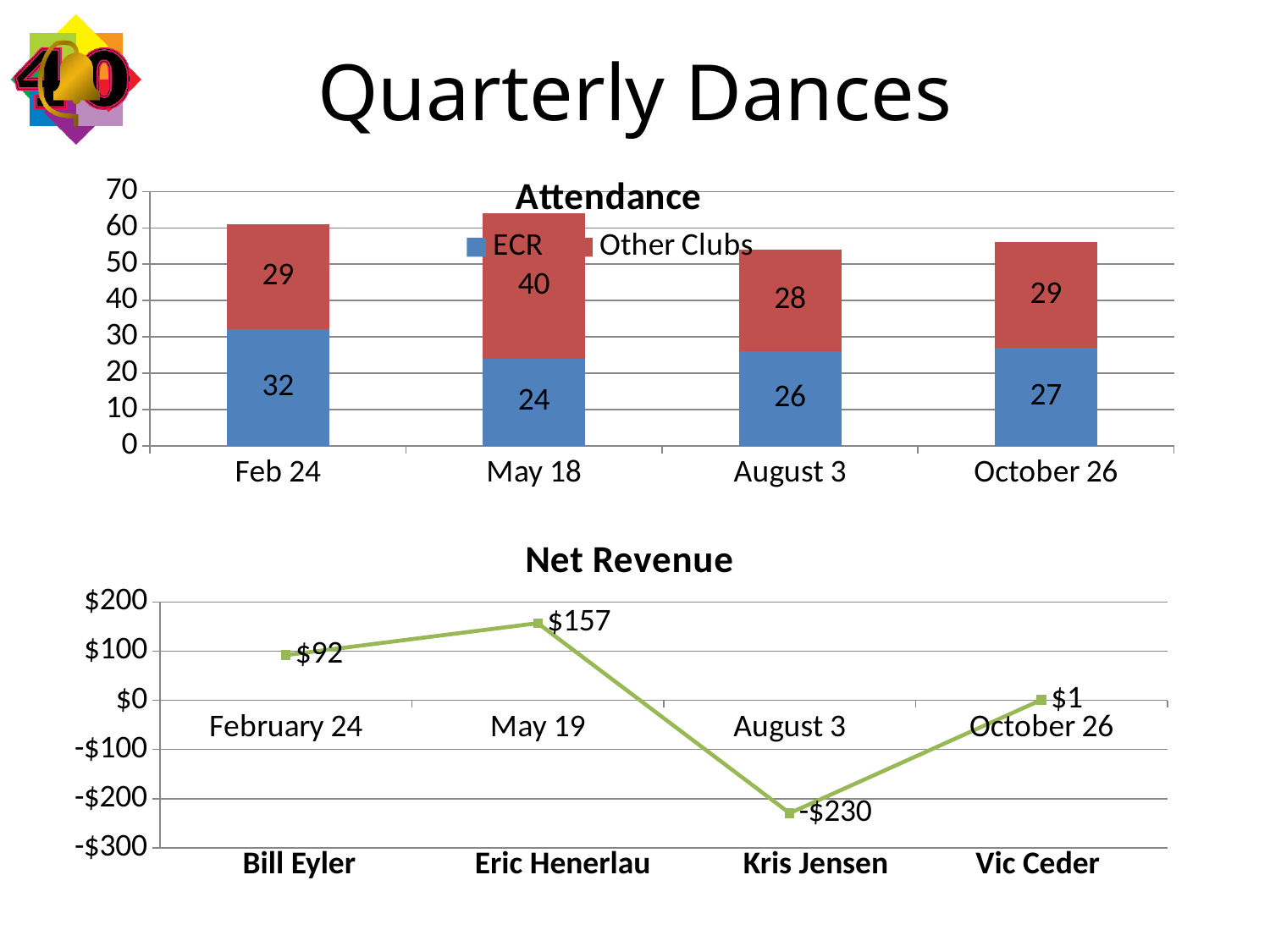
In the Net Revenue chart, which caller is listed under the October 26 point? Vic Ceder In the Attendance chart, how many series does the legend list? 2 In the Net Revenue chart, what is the value for August 3? -$230 In the Attendance chart, what is the difference between the Other Clubs value and the ECR value on May 18? 16 In the Net Revenue chart, what is the difference between the May 19 value and the February 24 value? $65 In the Attendance chart, which date has the highest ECR attendance? Feb 24 What kind of chart is the Attendance chart? Stacked bar chart In the Attendance chart, what is the total attendance for the August 3 bar? 54 In the Attendance chart, what is the Other Clubs value for May 18? 40 In the Attendance chart, what is the ECR value for Feb 24? 32 In the Attendance chart, what is the total attendance for the May 18 bar? 64 In the Net Revenue chart, which date has the highest net revenue? May 19